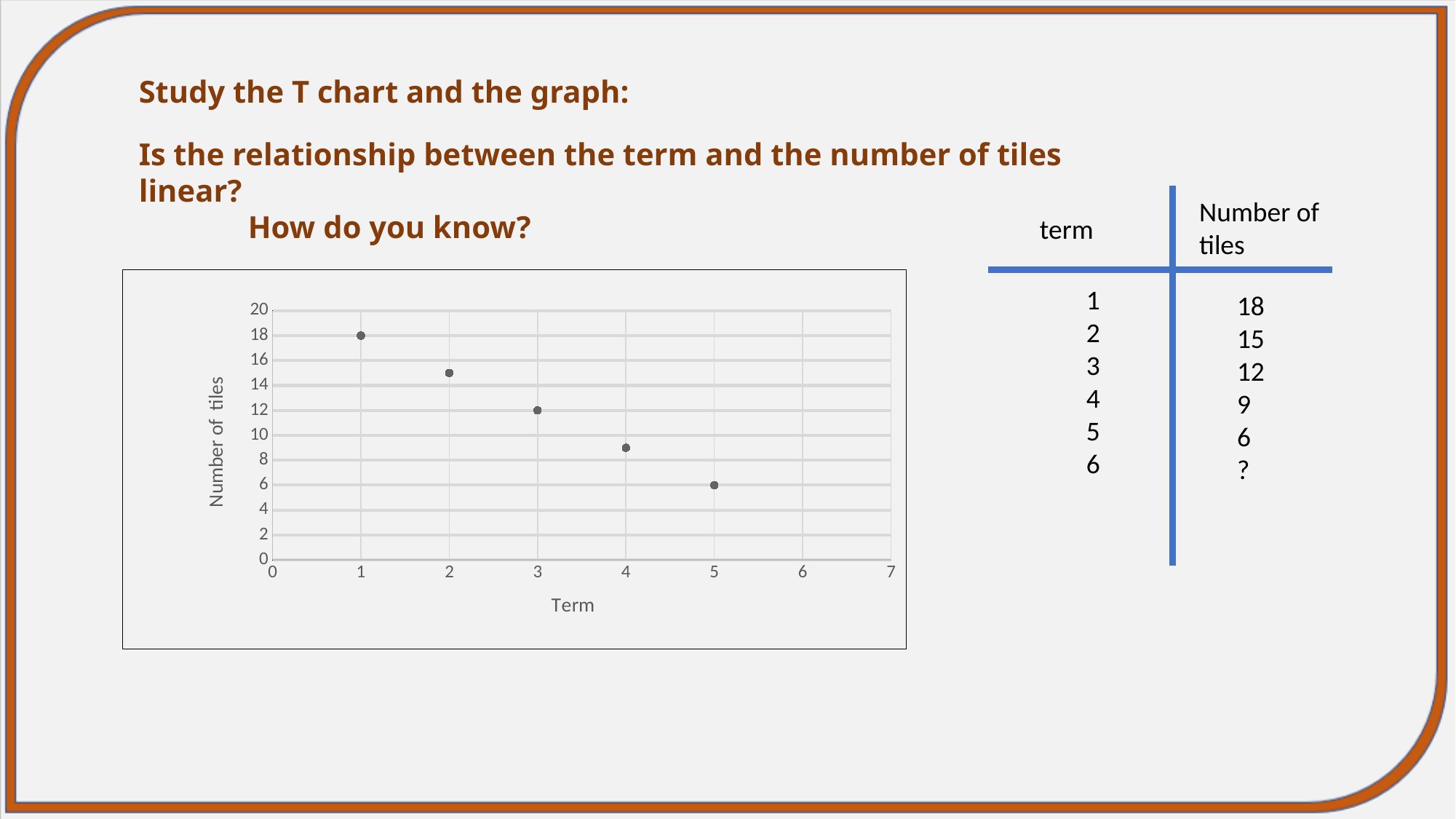
What is the number of tiles at term 1? 18 How many data points are plotted on the chart? 5 What kind of chart is shown on the slide? scatter plot Is the number of tiles at term 4 greater or less than 10? less Which has more tiles, term 2 or term 4? term 2 Do the values rise or fall as the term increases along the x axis? fall Which term has the highest number of tiles? 1 What is the label of the x axis? Term Which term has the lowest number of tiles? 5 What is the number of tiles at term 3? 12 What is the number of tiles at term 5? 6 What is the difference in number of tiles between term 1 and term 5? 12